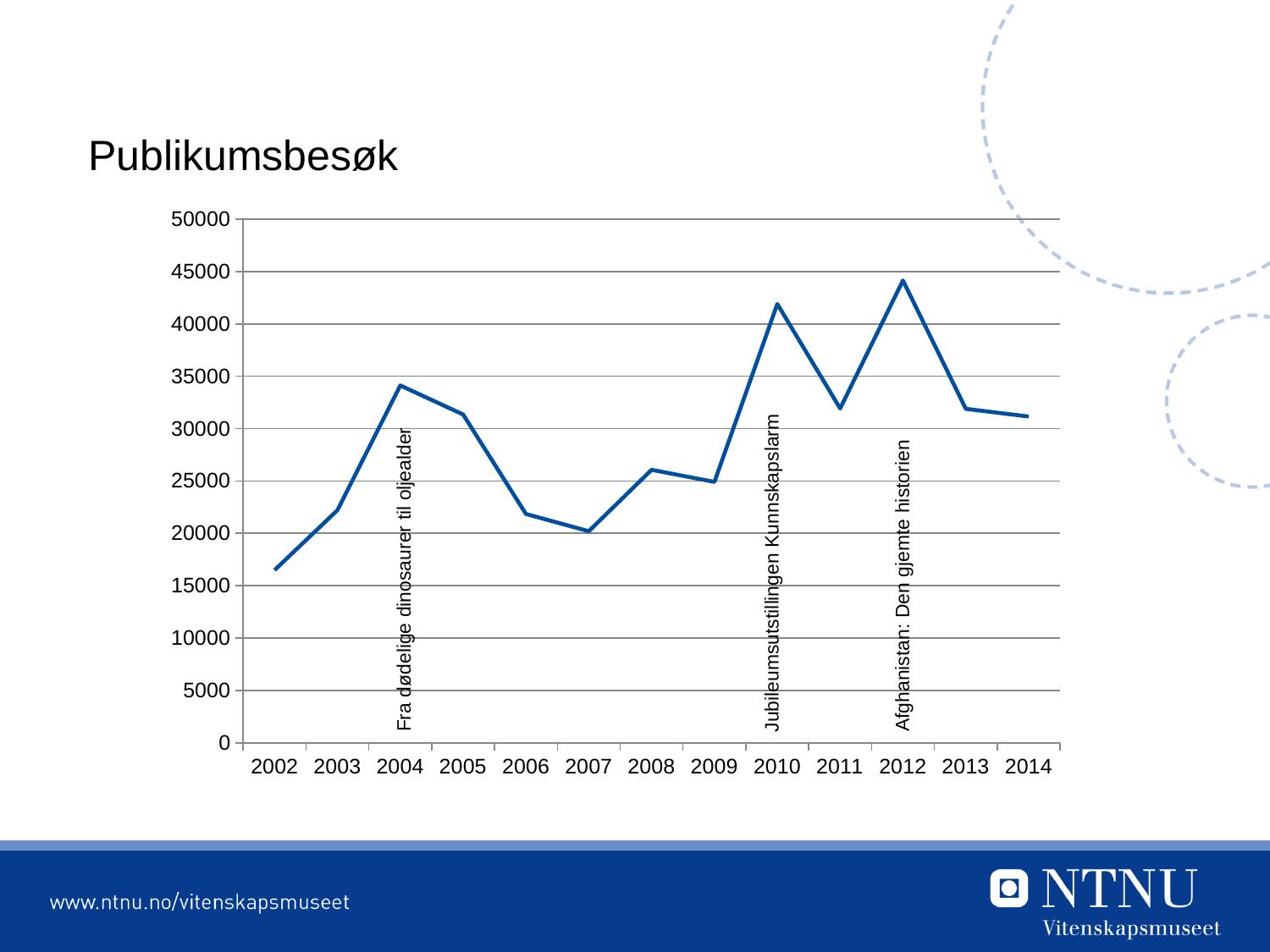
What is the title of the chart? Publikumsbesøk Is the value for 2010 greater or less than 40000? greater What kind of chart is shown on the slide? line chart Is the value for 2004 greater or less than 30000? greater Which year has the highest value? 2012 How many years are plotted along the x axis? 13 Is the value for 2007 greater or less than 25000? less Which exhibition is annotated at the 2010 point on the chart? Jubileumsutstillingen Kunnskapslarm Which year has the larger value, 2004 or 2007? 2004 Which year has the lowest value? 2002 Do the values rise or fall from 2004 to 2007? fall